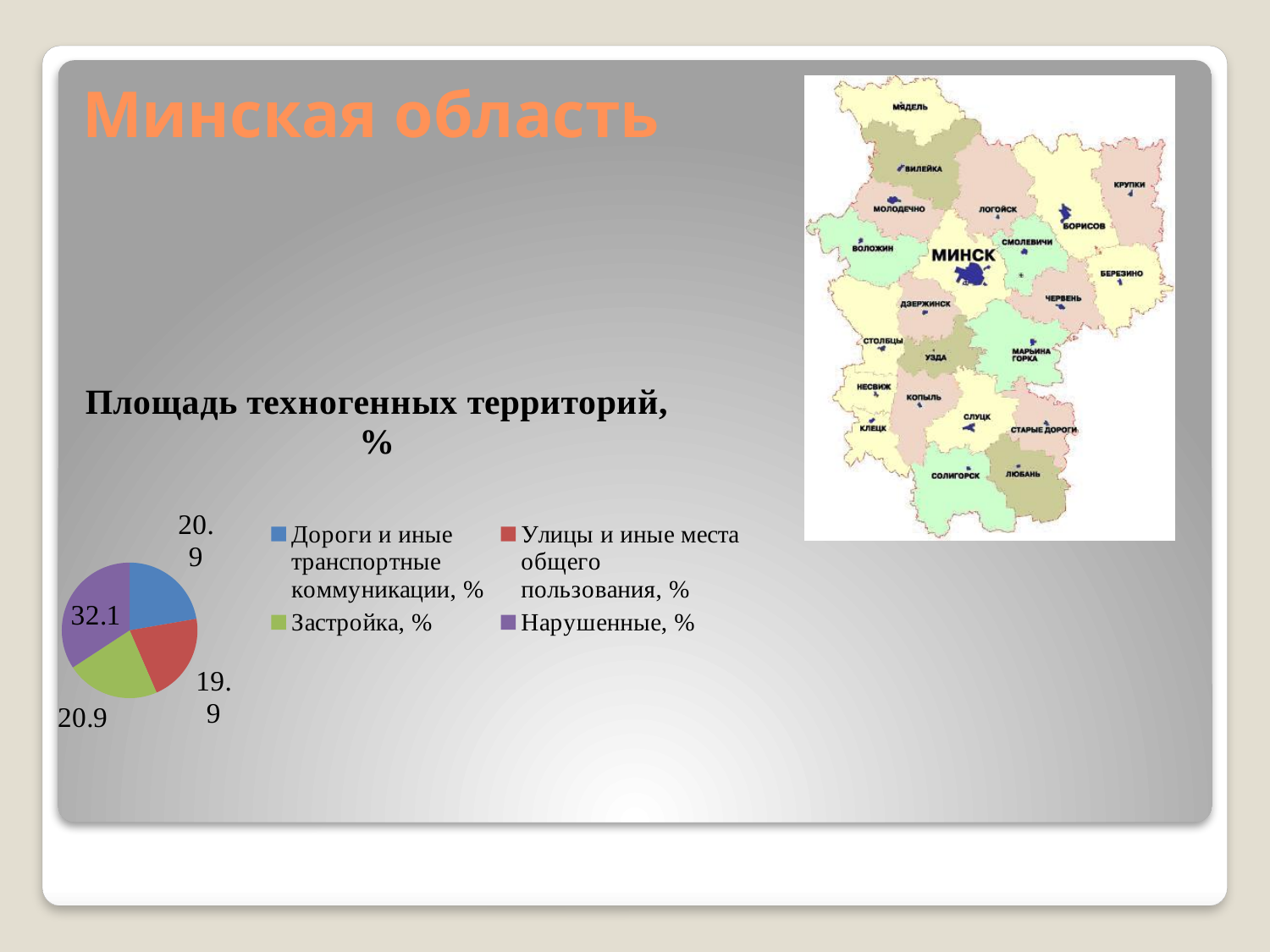
What is the title of the chart? Площадь техногенных территорий, % What is the value for Нарушенные, %? 32.1 What is the difference between the values for Нарушенные, % and Улицы и иные места общего пользования, %? 12.2 How many slices does the pie chart have? 4 What is the value for Застройка, %? 20.9 What kind of chart is shown on the slide? pie chart What is the value for Улицы и иные места общего пользования, %? 19.9 What is the value for Дороги и иные транспортные коммуникации, %? 20.9 Which is larger, the value for Нарушенные, % or the value for Застройка, %? Нарушенные, % What colour is the slice for Нарушенные, %? purple Which category has the smallest slice of the pie? Улицы и иные места общего пользования, % Which category has the largest slice of the pie? Нарушенные, %